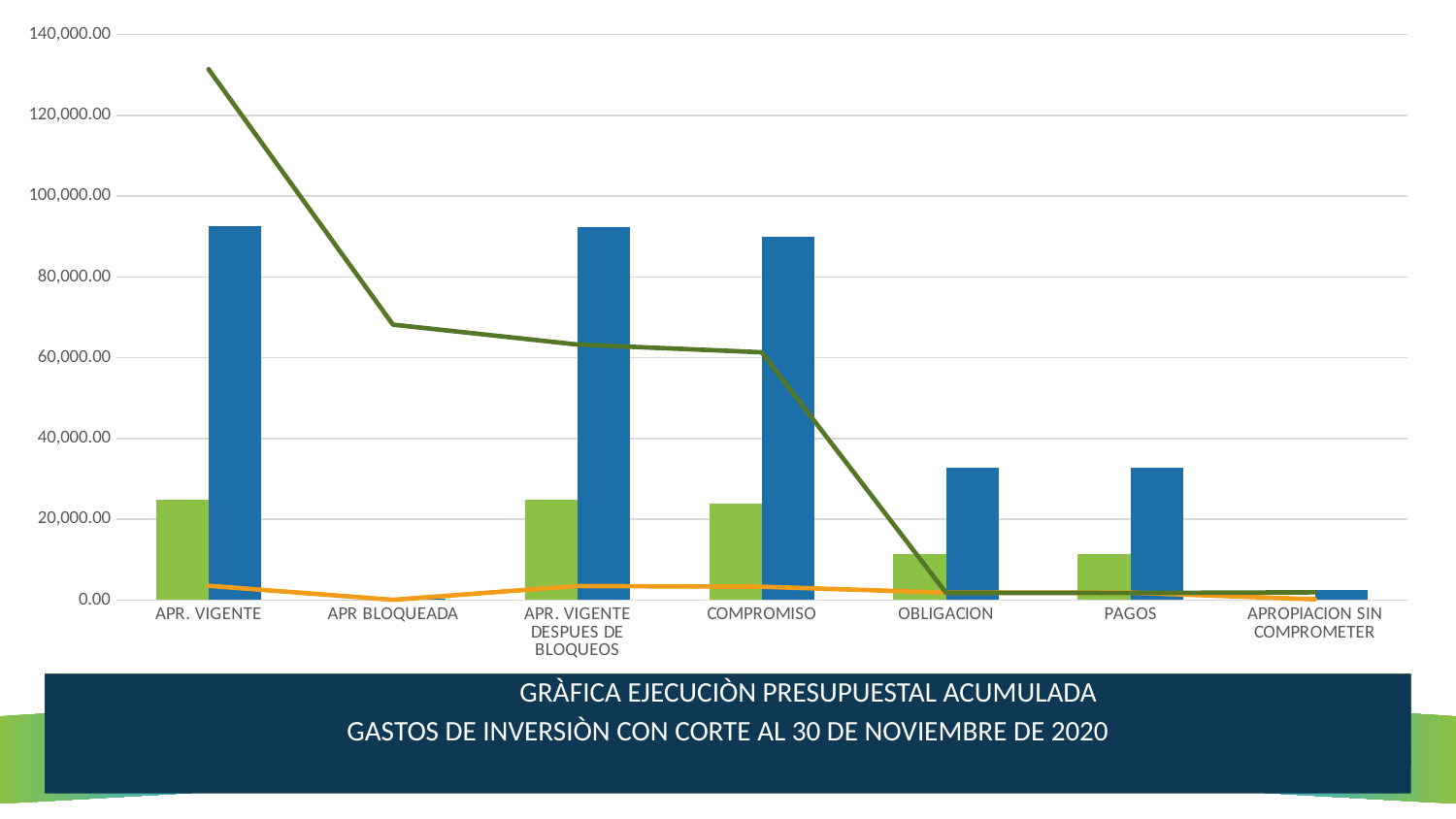
What is the title text shown below the chart? GRÀFICA EJECUCIÒN PRESUPUESTAL ACUMULADA GASTOS DE INVERSIÒN CON CORTE AL 30 DE NOVIEMBRE DE 2020 How many categories are shown on the x axis of the chart? 7 What is the highest value shown on the vertical axis of the chart? 140,000.00 Is the value of the blue bar for APROPIACION SIN COMPROMETER greater or less than 20,000.00? less Which blue bar is taller, COMPROMISO or OBLIGACION? COMPROMISO Does the dark green line generally rise or fall from APR. VIGENTE to APROPIACION SIN COMPROMETER? fall What kind of chart is shown on the slide? A combination chart of bars and lines Is the value of the dark green line at APR BLOQUEADA greater or less than 60,000.00? greater Is the value of the dark green line at APR. VIGENTE greater or less than 120,000.00? greater Which light green bar is taller, COMPROMISO or PAGOS? COMPROMISO